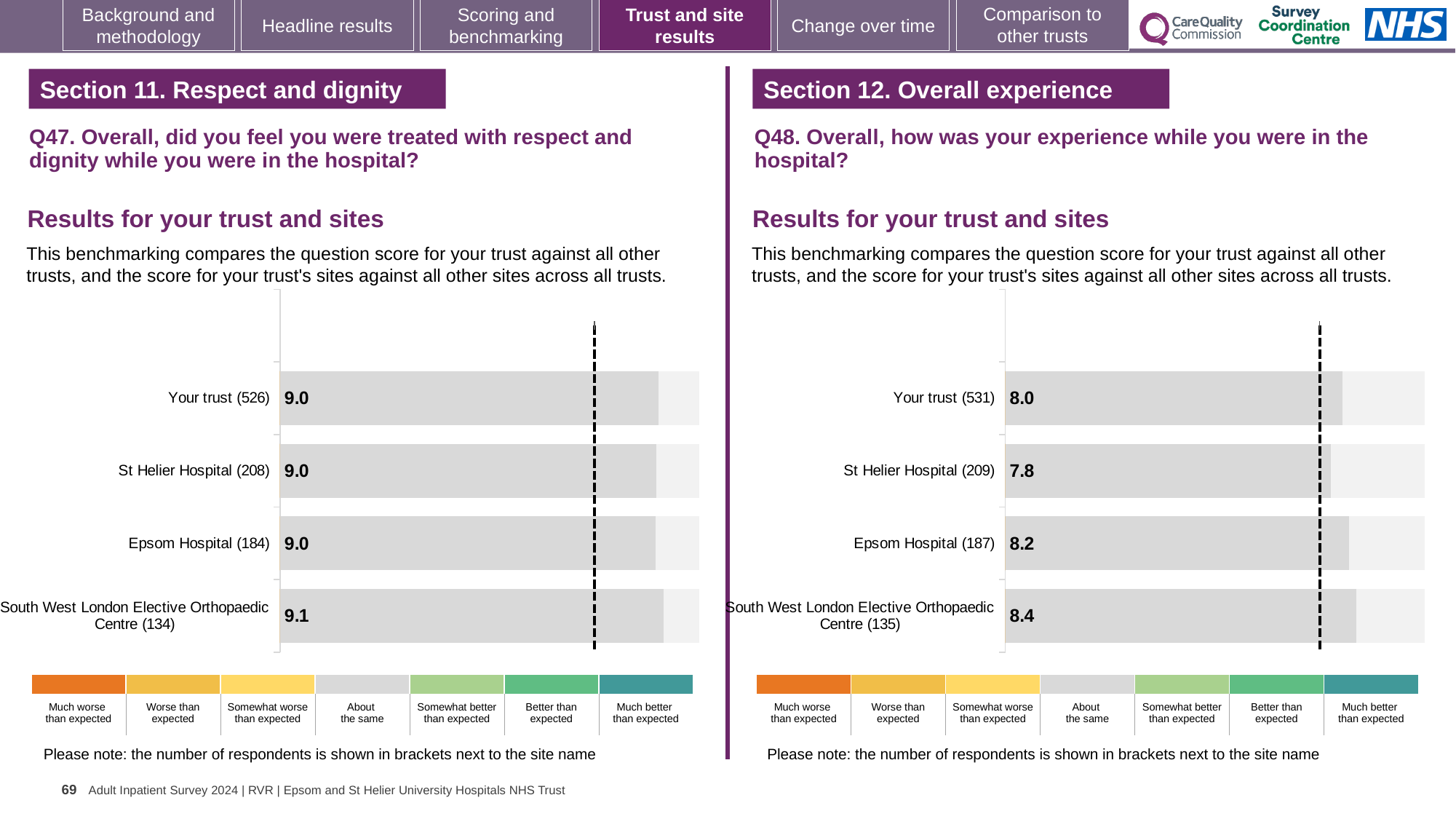
On the Q48 chart (right), what is the score for St Helier Hospital (209)? 7.8 On the Q47 chart (left), what is the difference between the scores for South West London Elective Orthopaedic Centre (134) and Your trust (526)? 0.1 What type of chart is used on the Q47 chart (left)? Bar chart How many categories does the colour key below the Q48 chart (right) list? 7 On the Q47 chart (left), what is the score for Your trust (526)? 9.0 On the Q48 chart (right), which has the larger score: Epsom Hospital (187) or Your trust (531)? Epsom Hospital (187) On the Q47 chart (left), what is the score for South West London Elective Orthopaedic Centre (134)? 9.1 On the Q47 chart (left), how many bars are plotted? 4 On the Q48 chart (right), which site or trust has the highest score? South West London Elective Orthopaedic Centre (135) On the Q48 chart (right), what is the score for Epsom Hospital (187)? 8.2 On the Q48 chart (right), which site or trust has the lowest score? St Helier Hospital (209) On the Q48 chart (right), what is the difference between the scores for South West London Elective Orthopaedic Centre (135) and St Helier Hospital (209)? 0.6